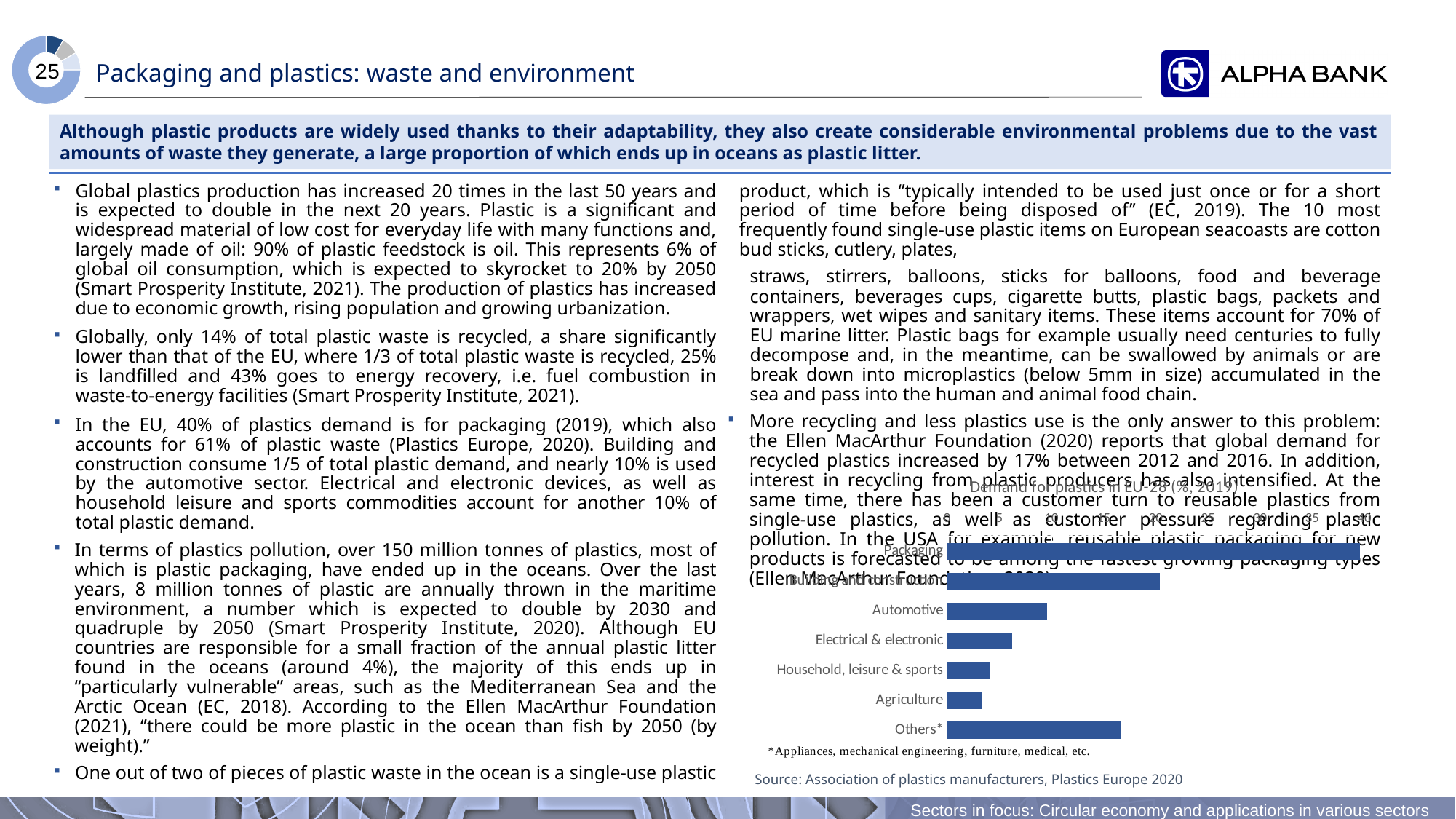
Is the value for Building and construction greater or less than 15? greater Which is larger, the value for Building and construction or the value for Others*? Building and construction What kind of chart is shown on the slide? Bar chart Is the value for Packaging greater or less than 30? greater Which category has the highest demand for plastics in the chart? Packaging Is the value for Others* greater or less than 10? greater Which is larger, the value for Automotive or the value for Electrical & electronic? Automotive How many categories are plotted in the chart? 7 What is the title of the chart? Demand for plastics in EU-28 (%, 2019)